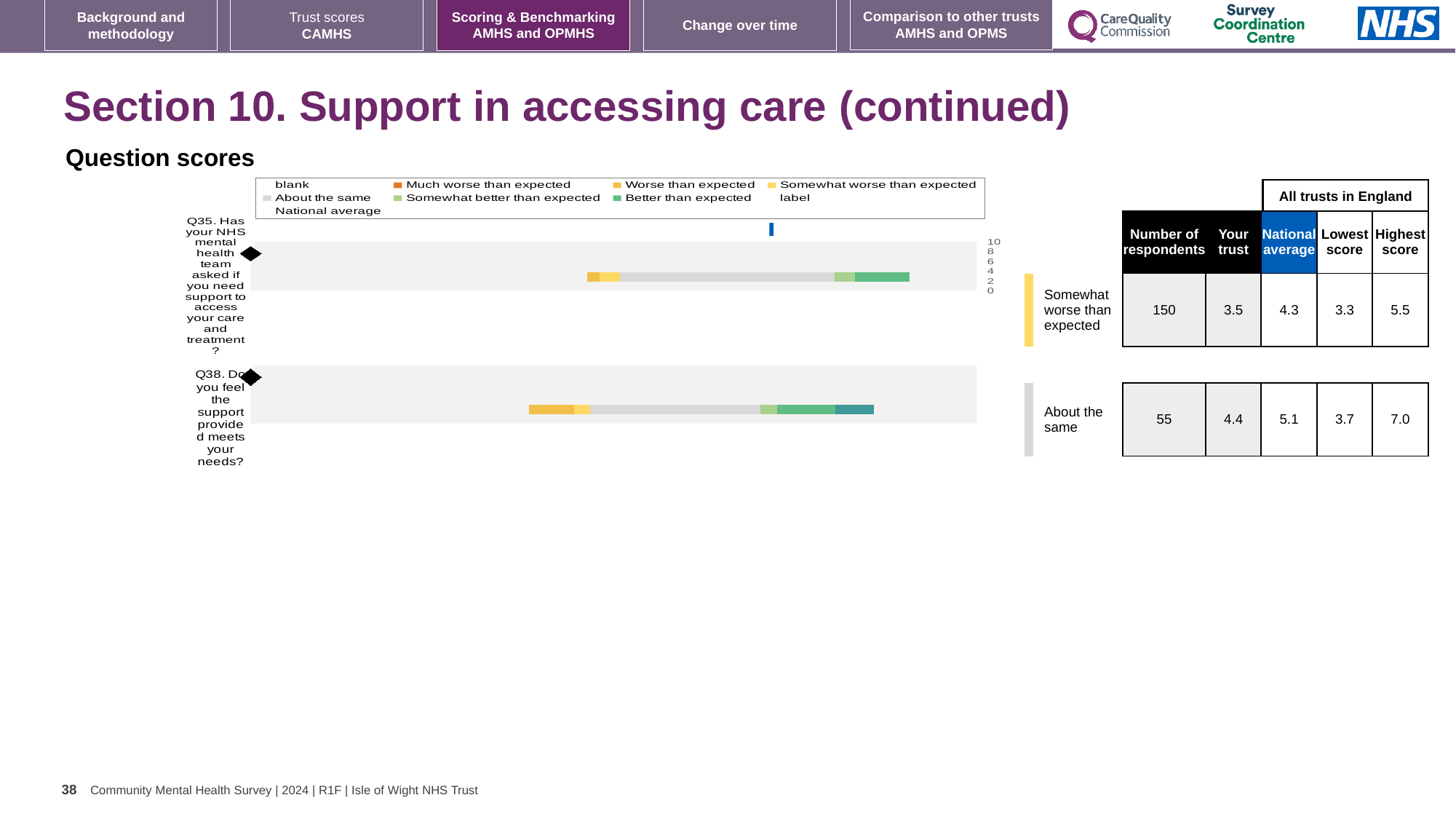
How many respondents answered Q35? 150 Which is larger for Q35: the trust's score or the national average? national average What is the 'Your trust' score for Q35 (Has your NHS mental health team asked if you need support to access your care and treatment?)? 3.5 What is the title of the table to the right of the chart, above the National average, Lowest score and Highest score columns? All trusts in England Which legend entry in the question scores chart is shown in dark orange? Much worse than expected What is the highest score across all trusts in England for Q38? 7.0 How many entries does the legend of the question scores chart list? 9 How many questions are plotted in the question scores chart? 2 What kind of chart is used to show the question scores on this slide? bar chart Which benchmark category is Q35 placed in? Somewhat worse than expected What is the difference between the highest score and the lowest score for Q35? 2.2 What is the national average score for Q38 (Do you feel the support provided meets your needs?)? 5.1